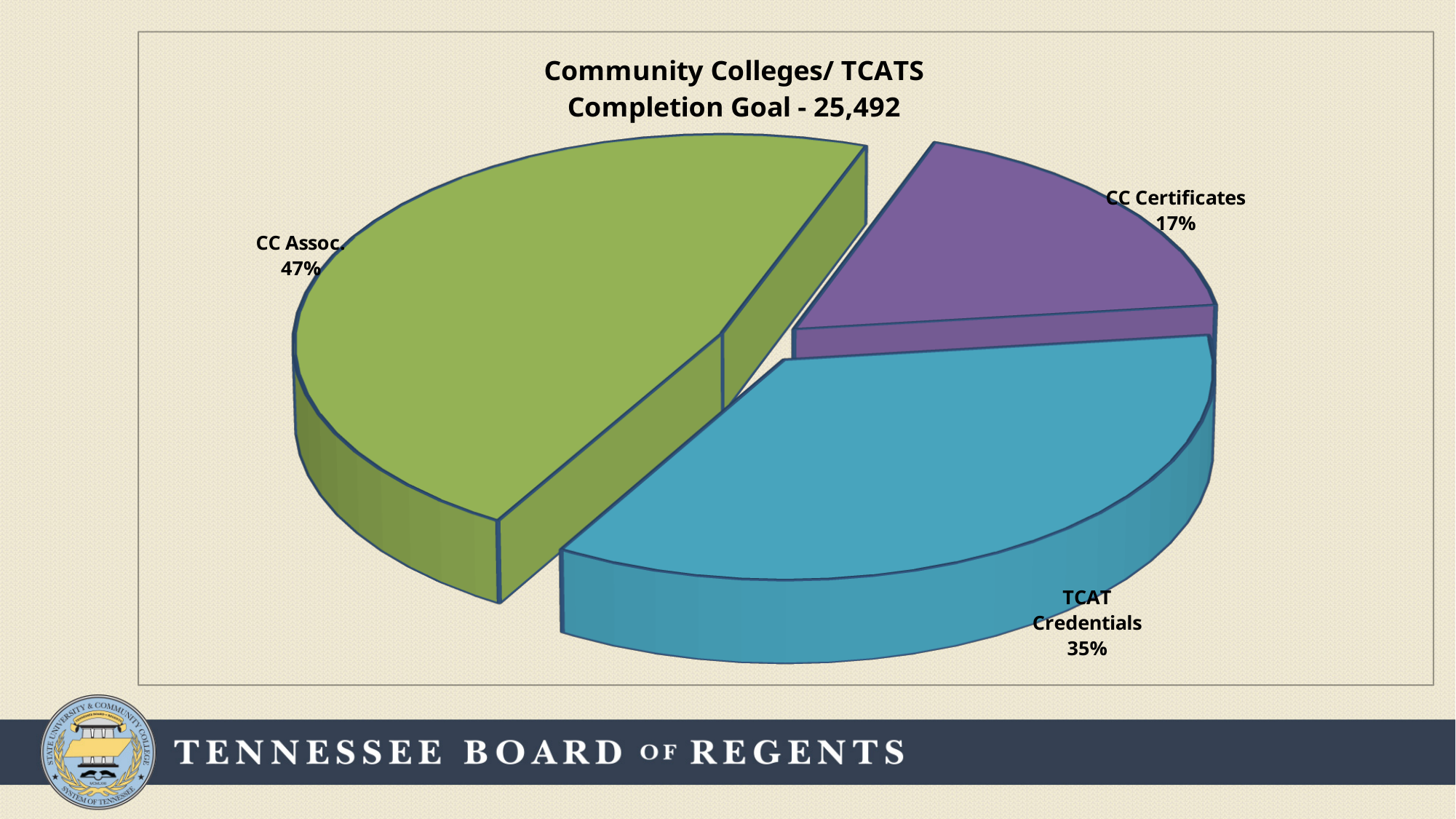
What colour is the CC Certificates slice? Purple What share of the pie does TCAT Credentials represent? 35% Which category has the smallest slice of the pie? CC Certificates What share of the pie does CC Assoc. represent? 47% Which category has the largest slice of the pie? CC Assoc. Which is larger, the share for TCAT Credentials or the share for CC Certificates? TCAT Credentials What share of the pie does CC Certificates represent? 17% What is the title of the chart? Community Colleges/ TCATS Completion Goal - 25,492 How many slices does the pie chart have? 3 What is the difference in percentage points between CC Assoc. and TCAT Credentials? 12 What is the difference in percentage points between TCAT Credentials and CC Certificates? 18 What kind of chart is shown on the slide? Pie chart